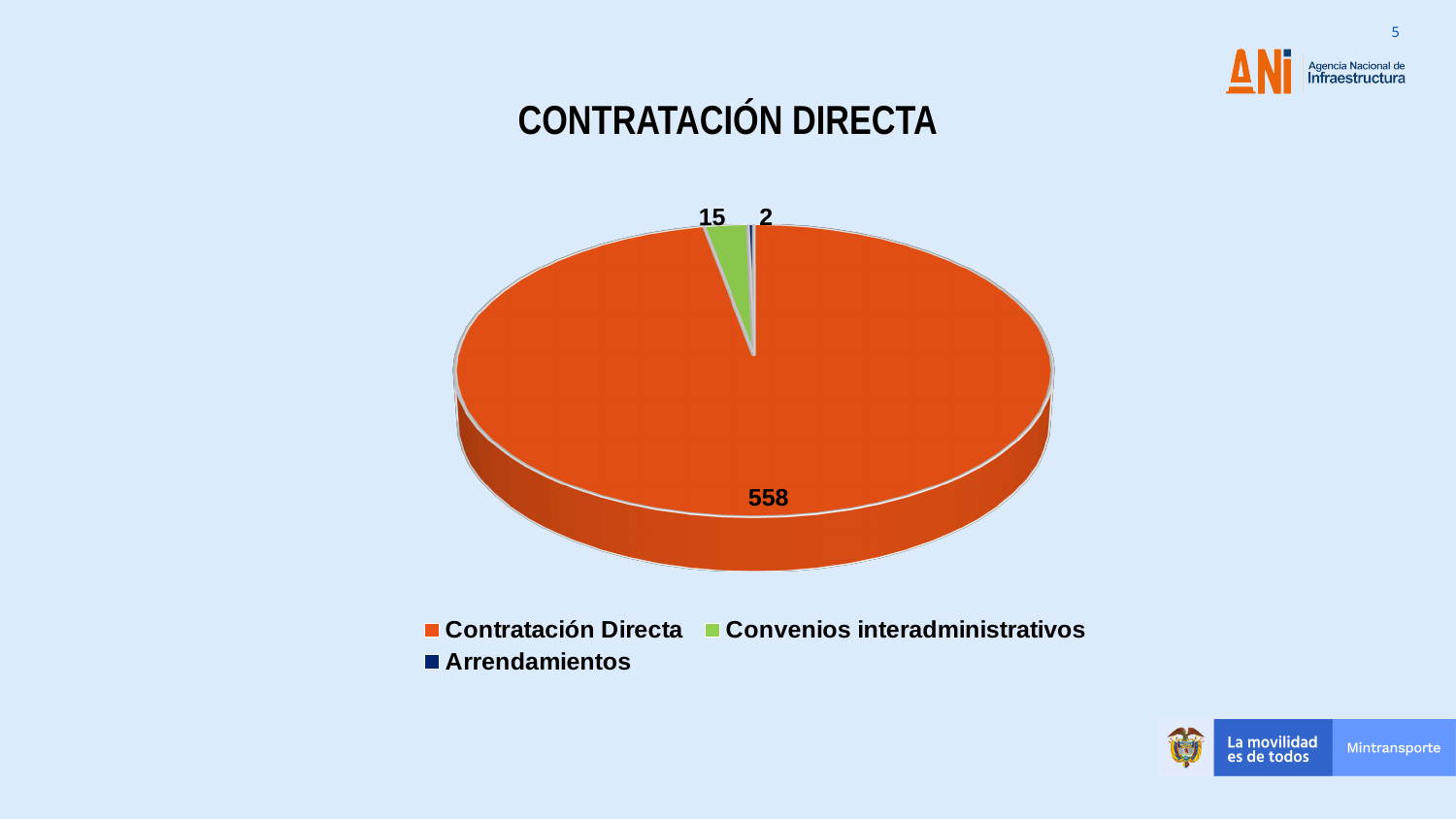
Which category has the smallest slice of the pie? Arrendamientos What is the total of all the slices in the pie chart? 575 How many categories does the pie chart have? 3 What is the difference between the values for Convenios interadministrativos and Arrendamientos? 13 Which is larger, Convenios interadministrativos or Arrendamientos? Convenios interadministrativos What is the title of the chart? CONTRATACIÓN DIRECTA What is the value for Convenios interadministrativos? 15 What is the difference between the values for Contratación Directa and Convenios interadministrativos? 543 Which category has the largest slice of the pie? Contratación Directa What type of chart is shown on the slide? pie chart What is the value for Arrendamientos? 2 What is the value for Contratación Directa? 558